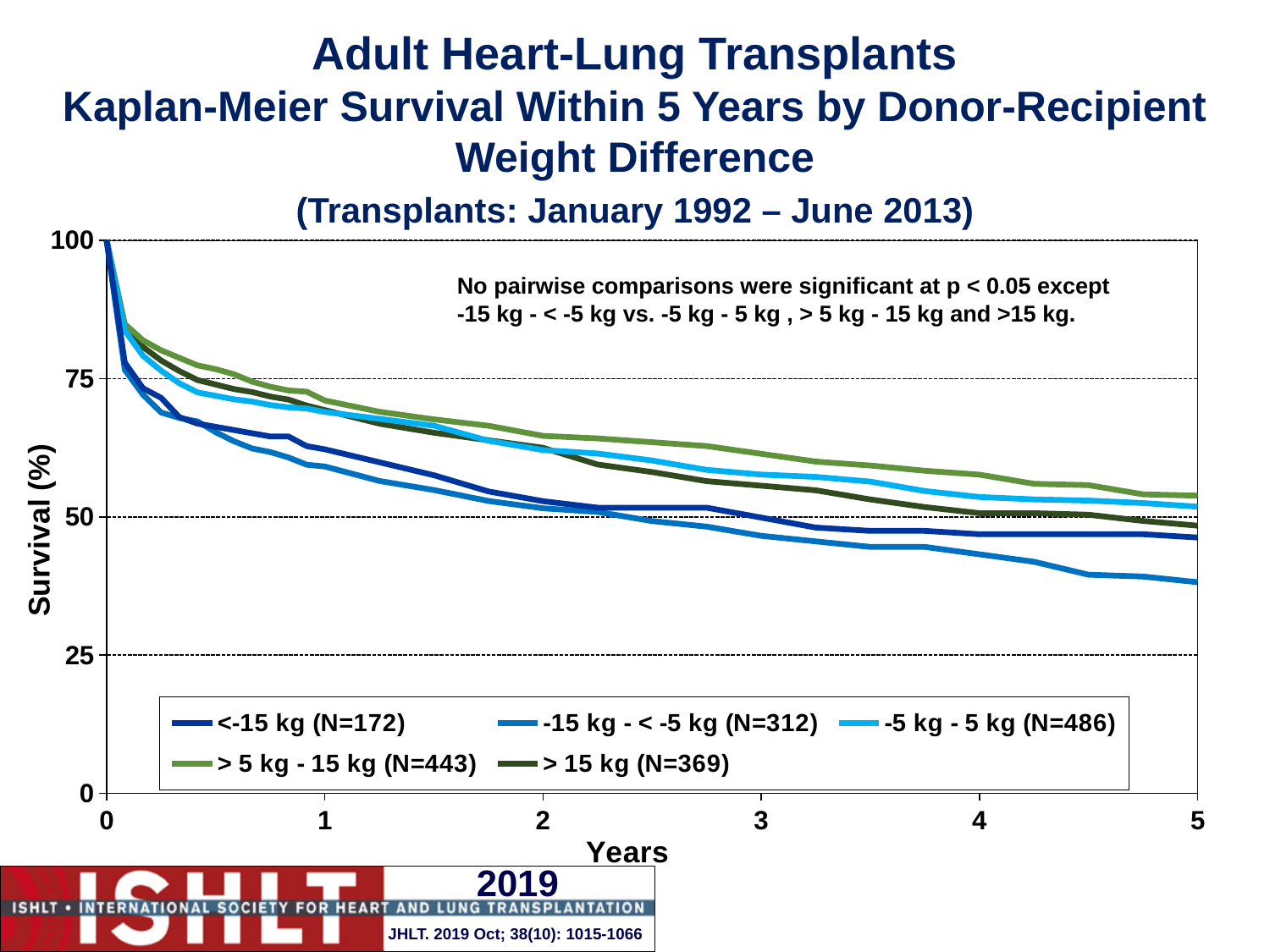
What is the survival (%) for all groups at year 0? 100 Which group has the lowest survival at 5 years? -15 kg - < -5 kg (N=312) What kind of chart is shown on the slide? line chart How many series does the legend list? 5 Is the survival for the > 5 kg - 15 kg group at 5 years greater or less than 50? greater Which group has the highest survival at 5 years? > 5 kg - 15 kg (N=443) Is the survival for the > 5 kg - 15 kg group at 1 year greater or less than 75? less What is the label of the y axis? Survival (%) At 5 years, which group has higher survival: > 5 kg - 15 kg or -15 kg - < -5 kg? > 5 kg - 15 kg What is the N for the -5 kg - 5 kg group shown in the legend? 486 Do the survival curves rise or fall as years increase? fall Is the survival for the -15 kg - < -5 kg group at 5 years greater or less than 50? less